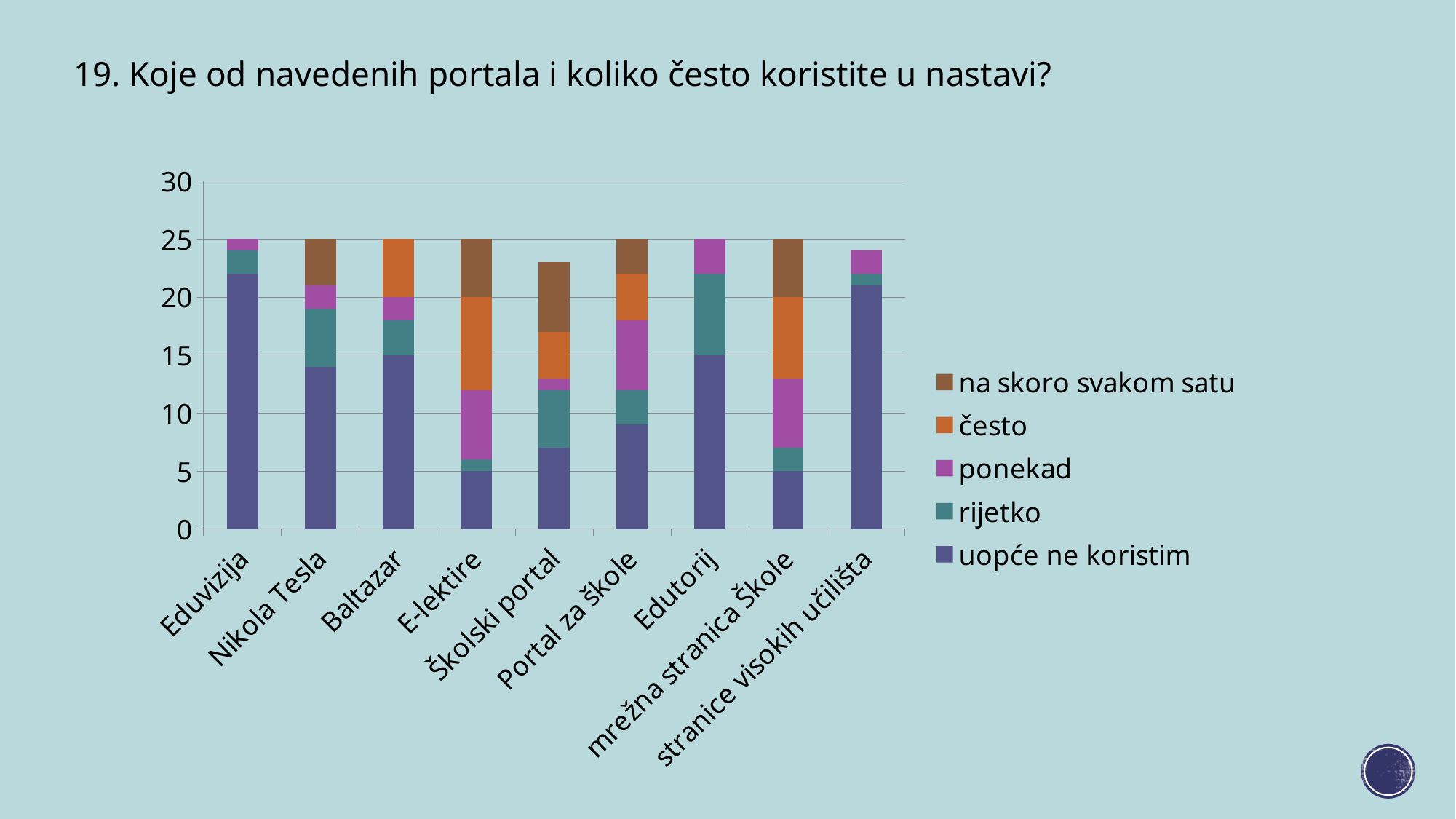
Is the value of 'uopće ne koristim' for Eduvizija greater or less than 20? greater What is the value of 'uopće ne koristim' for Edutorij? 15 Which has a larger 'uopće ne koristim' value, Baltazar or Školski portal? Baltazar How many portals (categories) are shown on the x axis? 9 Which legend entry is shown in orange? često What is the total height of the stacked bar for Eduvizija? 25 What is the total height of the stacked bar for Edutorij? 25 How many series does the legend list? 5 Is the value of 'uopće ne koristim' for Školski portal greater or less than 10? less What is the value of 'uopće ne koristim' for Baltazar? 15 What is the value of 'uopće ne koristim' for E-lektire? 5 What kind of chart is shown on the slide? stacked bar chart